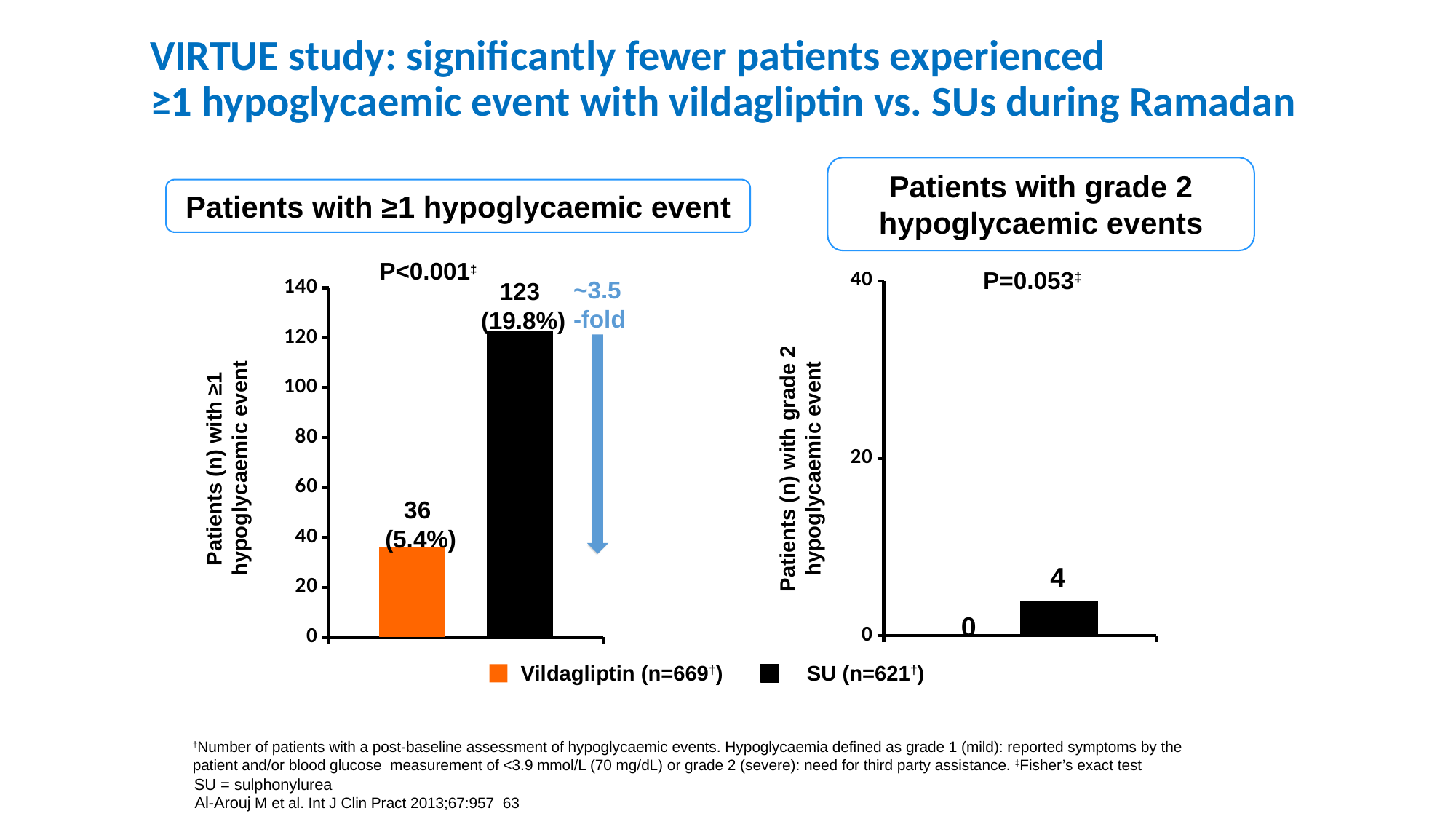
In the 'Patients with ≥1 hypoglycaemic event' chart, what is the difference in the number of patients between the SU and vildagliptin bars? 87 In the 'Patients with grade 2 hypoglycaemic events' chart, how many patients on SU had a grade 2 hypoglycaemic event? 4 In the 'Patients with grade 2 hypoglycaemic events' chart, which treatment group has the lower value? Vildagliptin How many series does the legend list? 2 What type of chart is the 'Patients with ≥1 hypoglycaemic event' chart? Bar chart In the 'Patients with ≥1 hypoglycaemic event' chart, how many patients on vildagliptin had ≥1 hypoglycaemic event? 36 In the 'Patients with ≥1 hypoglycaemic event' chart, what percentage of SU patients had ≥1 hypoglycaemic event? 19.8% In the 'Patients with ≥1 hypoglycaemic event' chart, which treatment group has the higher number of patients? SU In the 'Patients with ≥1 hypoglycaemic event' chart, how many patients on SU had ≥1 hypoglycaemic event? 123 In the 'Patients with grade 2 hypoglycaemic events' chart, how many patients on vildagliptin had a grade 2 hypoglycaemic event? 0 What P value is shown on the 'Patients with grade 2 hypoglycaemic events' chart? P=0.053 In the 'Patients with ≥1 hypoglycaemic event' chart, what percentage of vildagliptin patients had ≥1 hypoglycaemic event? 5.4%